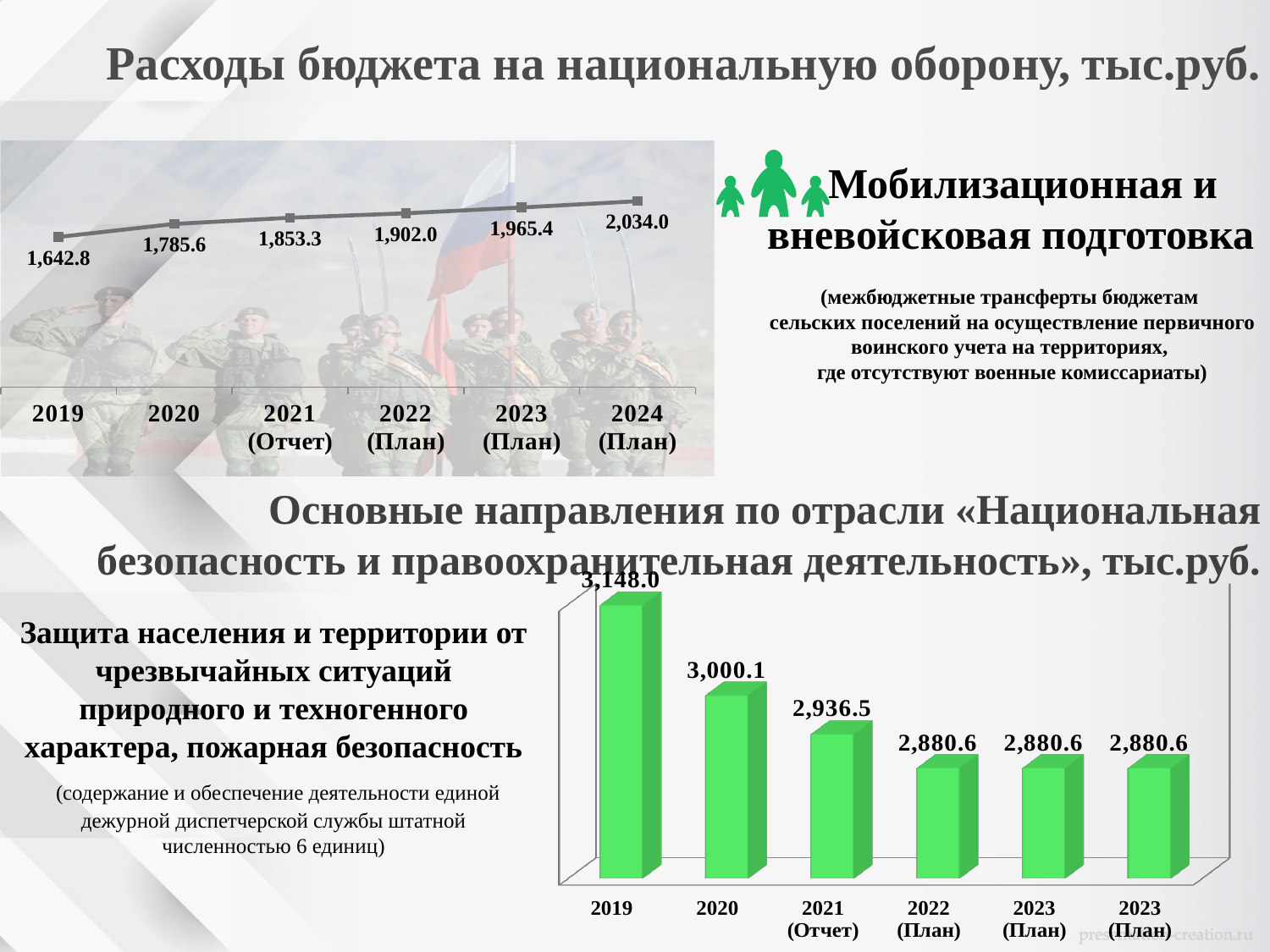
In the top line chart (Расходы бюджета на национальную оборону), do the values rise or fall from 2019 to 2024? rise In the top line chart (Расходы бюджета на национальную оборону), what is the value for 2024 (План)? 2,034.0 In the bottom bar chart, what is the value for 2019? 3,148.0 In the bottom bar chart, which is larger: the value for 2020 or the value for 2022 (План)? 2020 In the bottom bar chart, what is the value for 2021 (Отчет)? 2,936.5 In the top line chart (Расходы бюджета на национальную оборону), how many data points are plotted? 6 In the bottom bar chart, what is the difference between the 2019 value and the 2020 value? 147.9 In the top line chart (Расходы бюджета на национальную оборону), what is the value for 2021 (Отчет)? 1,853.3 What type of chart is the bottom chart on the slide? bar chart In the top line chart (Расходы бюджета на национальную оборону), what is the difference between the 2024 (План) value and the 2019 value? 391.2 In the bottom bar chart, which year has the highest value? 2019 In the top line chart (Расходы бюджета на национальную оборону), what is the value for 2019? 1,642.8